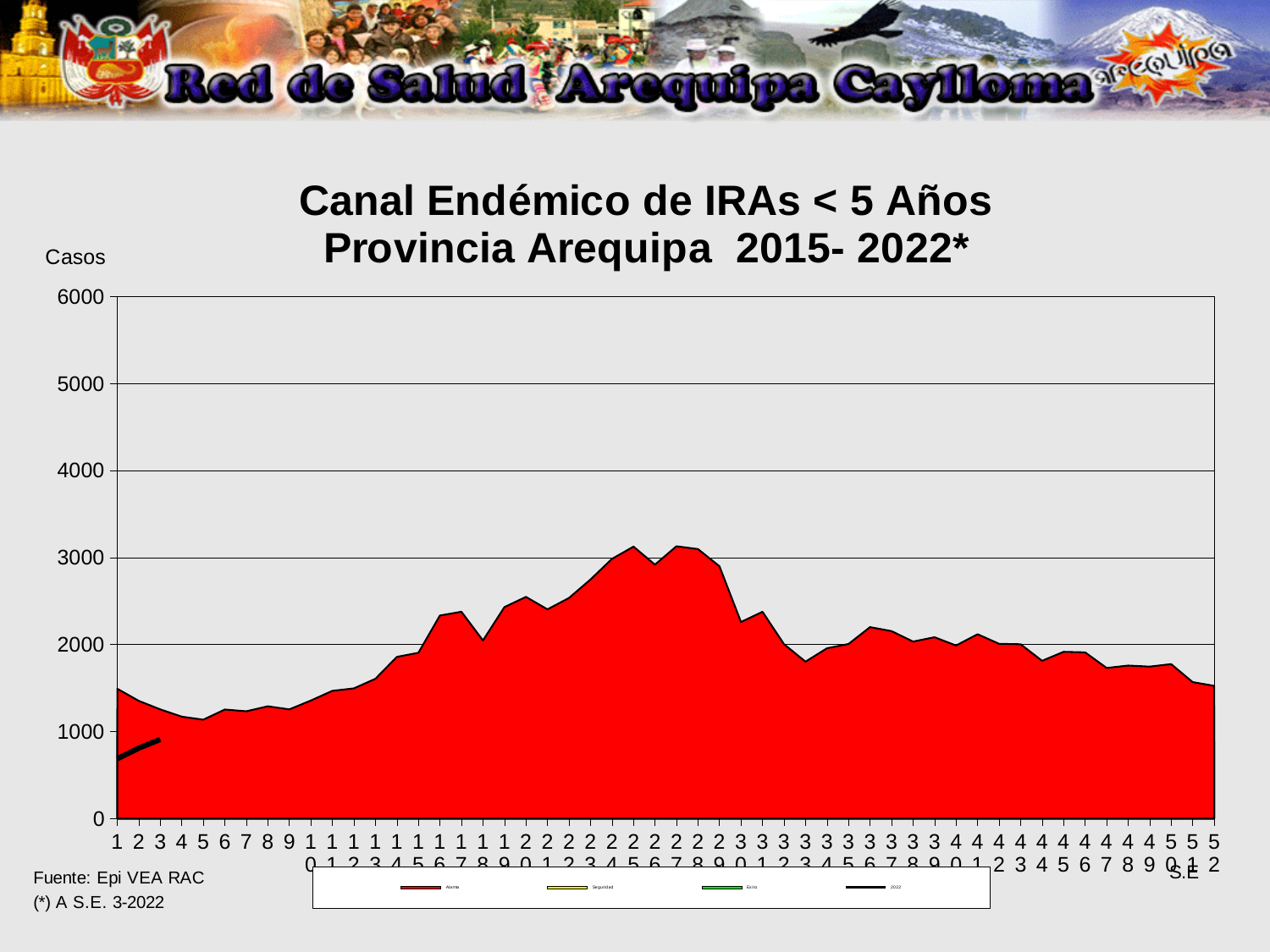
What kind of chart is shown on the slide? area chart How many epidemiological weeks (S.E.) are shown along the x axis? 52 Is the value of the red Alarma band at week 25 greater or less than 2000? greater How many series does the legend list? 4 Does the red Alarma band rise or fall from week 1 to week 5? fall Is the value of the red Alarma band at week 52 greater or less than 2000? less What is the title of the chart? Canal Endémico de IRAs < 5 Años Provincia Arequipa 2015- 2022* Is the value of the red Alarma band at week 30 greater or less than 2000? greater Does the red Alarma band rise or fall from week 10 to week 25? rise What label is shown on the vertical axis of the chart? Casos